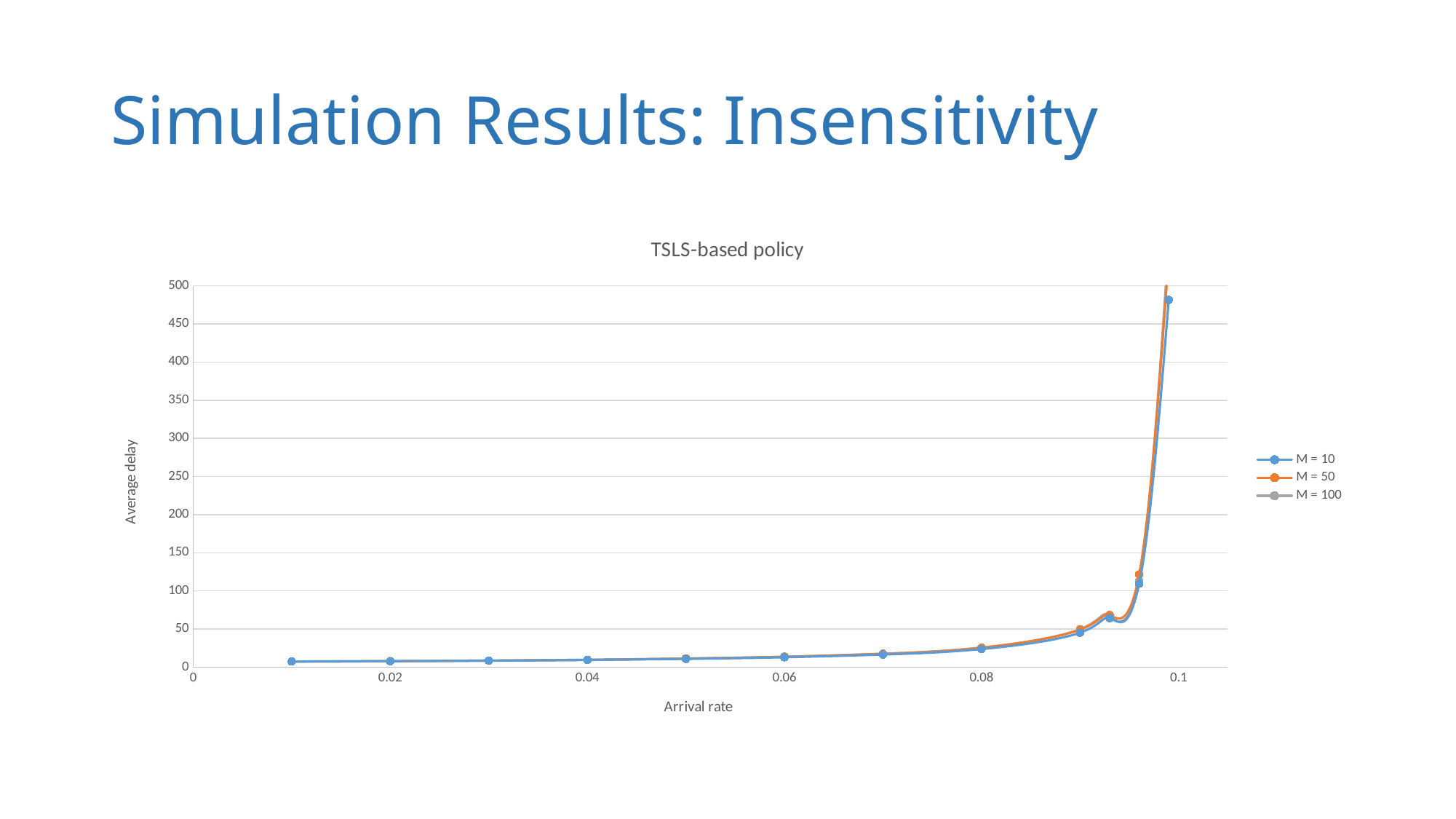
Is the average delay for M = 50 at an arrival rate of 0.04 greater or less than 100? less How many series does the legend list? 3 What are the three series named in the legend? M = 10, M = 50, M = 100 Is the highest plotted average delay for M = 10 greater or less than 400? greater What is the title of the chart? TSLS-based policy Is the average delay for M = 10 at an arrival rate of 0.06 greater or less than 50? less Does the average delay rise or fall as the arrival rate increases along the x axis? Rise What kind of chart is shown on the slide? Line chart